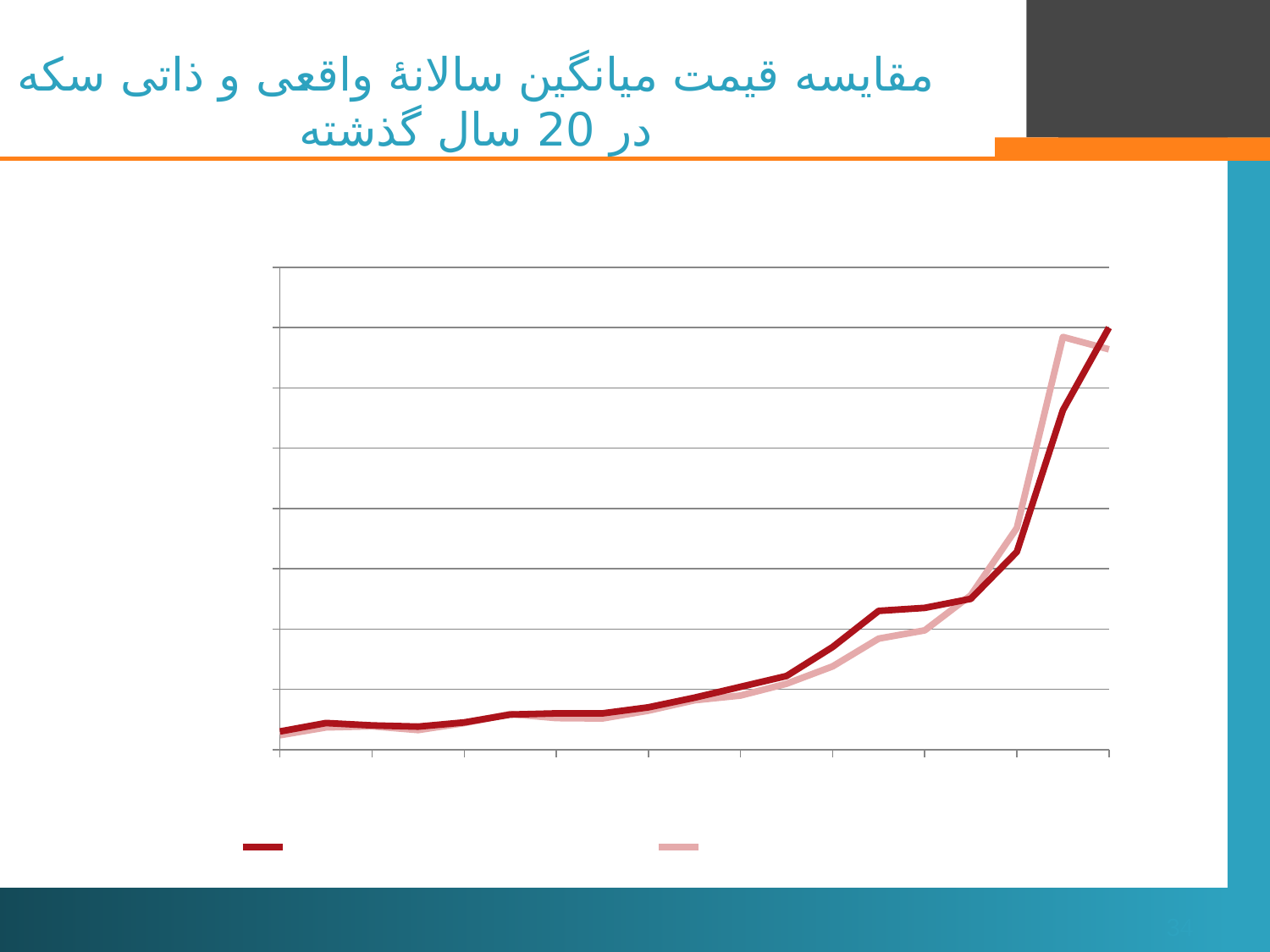
What two colours are used for the lines in the chart? dark red and light pink At the second-to-last point of the chart, which line is higher, the dark red line or the light pink line? light pink What is the title of the slide? مقایسه قیمت میانگین سالانۀ واقعی و ذاتی سکه در 20 سال گذشته Does the dark red line end higher or lower than where it starts? higher How many series does the legend below the chart show? 2 Do the plotted values generally rise or fall from left to right along the x axis? rise What kind of chart is shown on the slide? line chart At the rightmost point of the chart, which line is higher, the dark red line or the light pink line? dark red